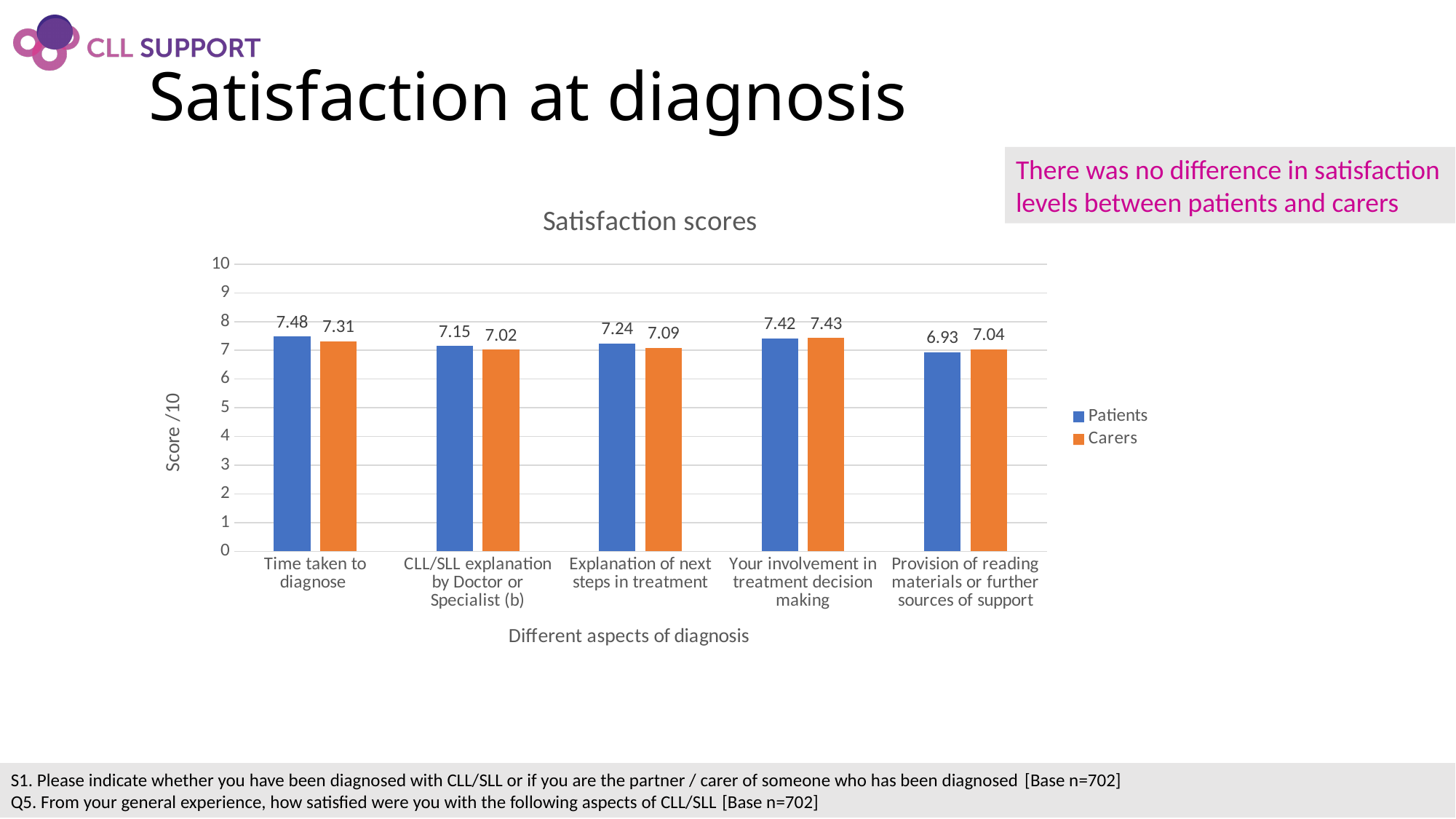
What is the Carers score for Explanation of next steps in treatment? 7.09 What is the Carers satisfaction score for Provision of reading materials or further sources of support? 7.04 What is the title of the chart? Satisfaction scores How many aspects of diagnosis are shown on the x axis? 5 For Provision of reading materials or further sources of support, which is higher: the Patients score or the Carers score? Carers What is the difference between the Patients and Carers scores for Time taken to diagnose? 0.17 What is the Patients satisfaction score for Time taken to diagnose? 7.48 Is the Patients score for Provision of reading materials or further sources of support greater or less than 7? less How many series does the legend list? 2 Which aspect has the lowest Carers score? CLL/SLL explanation by Doctor or Specialist (b) Which aspect has the highest Patients score? Time taken to diagnose What type of chart is shown? Bar chart